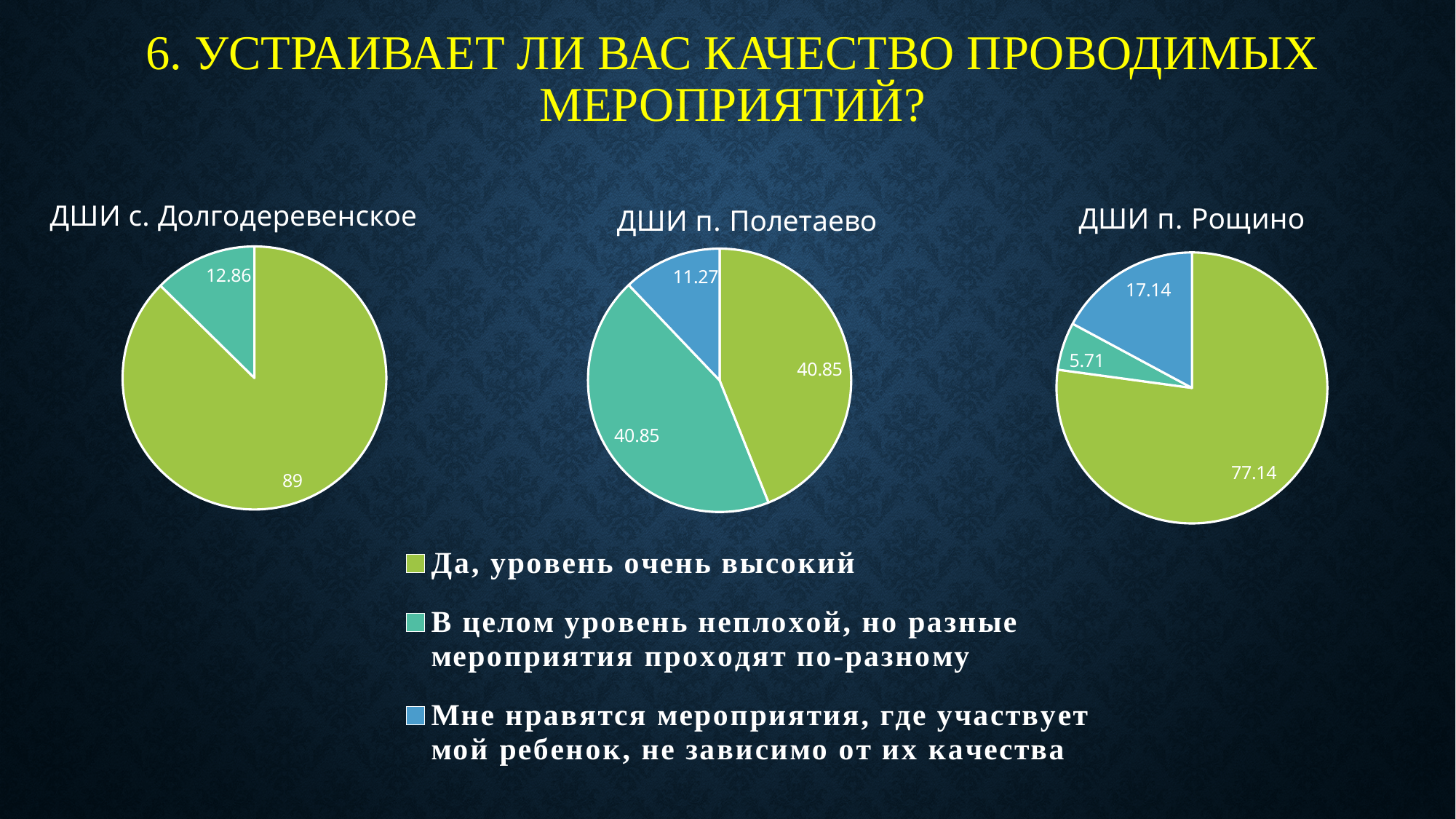
In the pie chart titled "ДШИ п. Рощино", what is the difference between the values for "Да, уровень очень высокий" and "Мне нравятся мероприятия, где участвует мой ребенок, не зависимо от их качества"? 60 In the pie chart titled "ДШИ п. Рощино", which is larger: the slice for "Мне нравятся мероприятия, где участвует мой ребенок, не зависимо от их качества" or the slice for "В целом уровень неплохой, но разные мероприятия проходят по-разному"? Мне нравятся мероприятия, где участвует мой ребенок, не зависимо от их качества In the pie chart titled "ДШИ п. Рощино", what is the value for "Да, уровень очень высокий"? 77.14 In the pie chart titled "ДШИ п. Рощино", what is the value for "В целом уровень неплохой, но разные мероприятия проходят по-разному"? 5.71 In the pie chart titled "ДШИ п. Полетаево", which category has the smallest slice? Мне нравятся мероприятия, где участвует мой ребенок, не зависимо от их качества How many entries does the shared legend list? 3 In the pie chart titled "ДШИ п. Рощино", which category has the smallest slice? В целом уровень неплохой, но разные мероприятия проходят по-разному In the pie chart titled "ДШИ с. Долгодеревенское", what is the value for "В целом уровень неплохой, но разные мероприятия проходят по-разному"? 12.86 How many slices does the pie chart titled "ДШИ с. Долгодеревенское" have? 2 What kind of chart is the chart titled "ДШИ п. Полетаево"? Pie chart In the pie chart titled "ДШИ с. Долгодеревенское", what is the value for "Да, уровень очень высокий"? 89 In the pie chart titled "ДШИ п. Полетаево", what is the value for "Мне нравятся мероприятия, где участвует мой ребенок, не зависимо от их качества"? 11.27